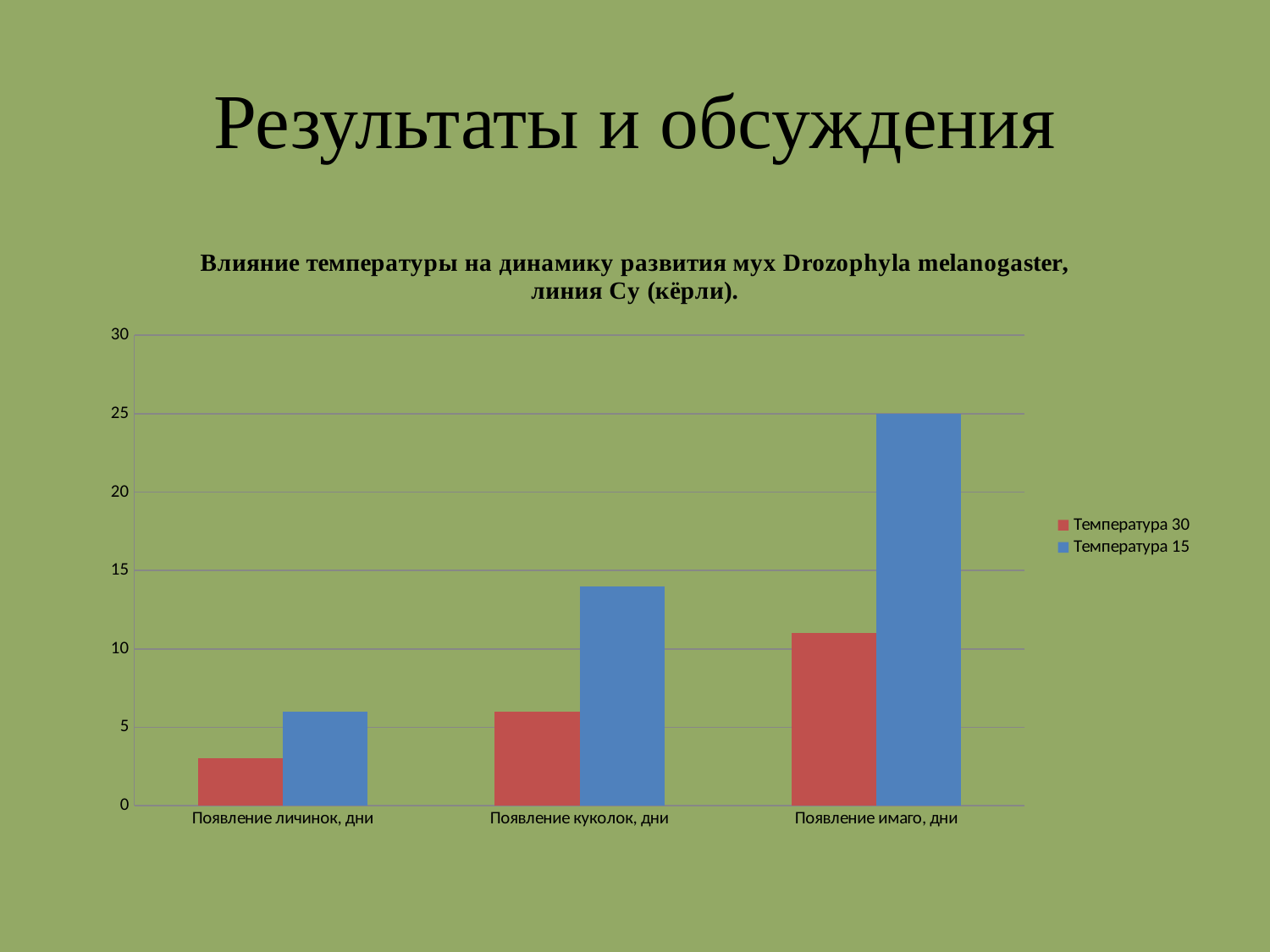
In which category is the Температура 15 series highest? Появление имаго, дни Is the value for Температура 30 in the category Появление личинок, дни greater or less than 5? less What is the value for Температура 15 in the category Появление имаго, дни? 25 In which category is the Температура 30 series lowest? Появление личинок, дни Is the value for Температура 15 in the category Появление куколок, дни greater or less than 10? greater In the category Появление куколок, дни, which series has the larger value, Температура 30 or Температура 15? Температура 15 How many categories are shown on the x axis? 3 Do the values of the Температура 15 series rise or fall from left to right along the x axis? rise Which colour represents the Температура 30 series in the legend? red What kind of chart is shown on the slide? bar chart How many series does the legend list? 2 Is the value for Температура 30 in the category Появление имаго, дни greater or less than 15? less